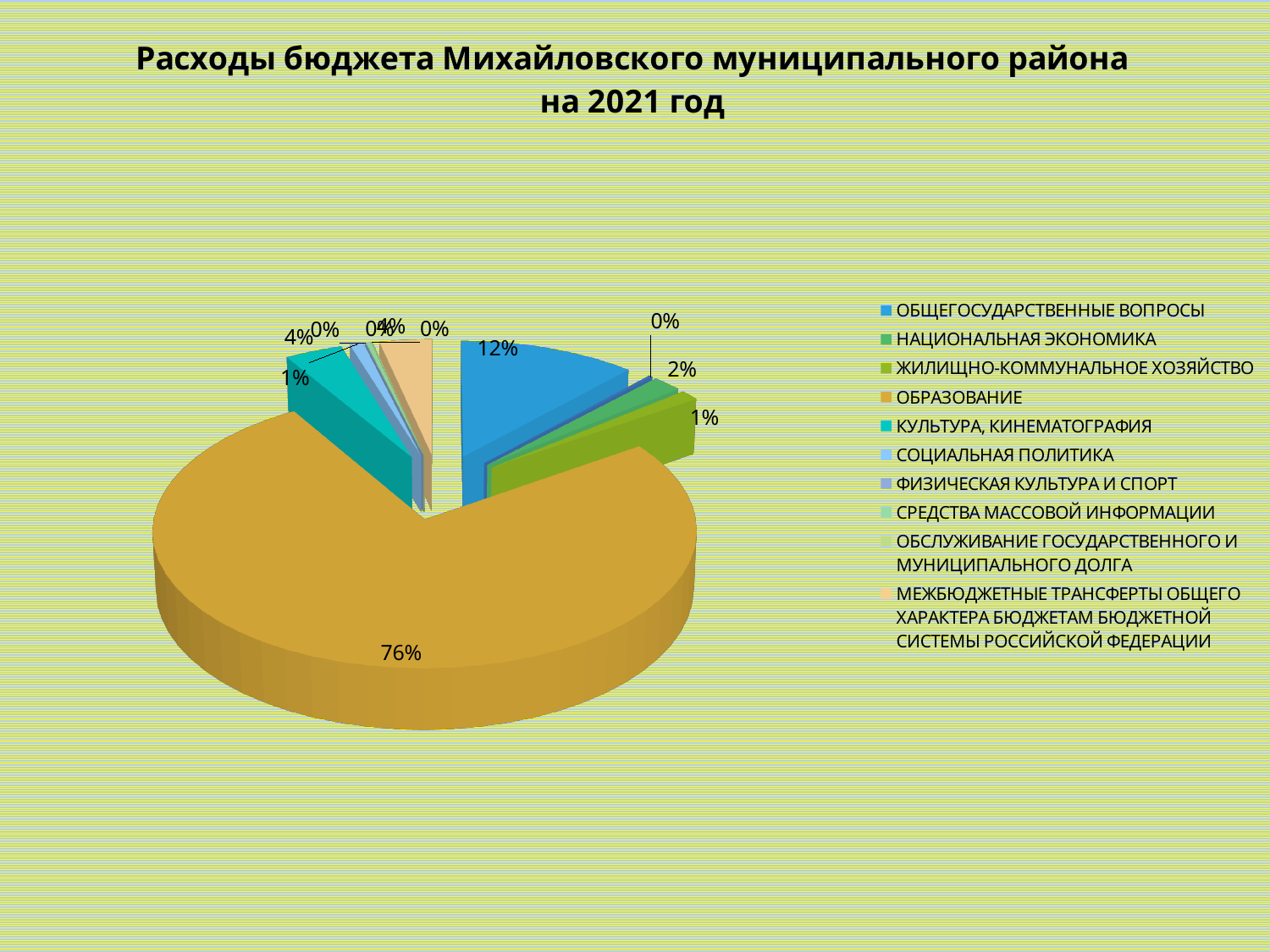
What share of the pie does ОБРАЗОВАНИЕ take? 76% By how many percentage points does ОБРАЗОВАНИЕ exceed ОБЩЕГОСУДАРСТВЕННЫЕ ВОПРОСЫ? 64 percentage points Which category has the largest slice of the pie? ОБРАЗОВАНИЕ Which is larger, the slice for НАЦИОНАЛЬНАЯ ЭКОНОМИКА or the slice for ЖИЛИЩНО-КОММУНАЛЬНОЕ ХОЗЯЙСТВО? НАЦИОНАЛЬНАЯ ЭКОНОМИКА What is the value shown for ОБЩЕГОСУДАРСТВЕННЫЕ ВОПРОСЫ? 12% What colour is the slice for ОБРАЗОВАНИЕ? orange What is the value shown for ЖИЛИЩНО-КОММУНАЛЬНОЕ ХОЗЯЙСТВО? 1% How many categories does the legend list? 10 What kind of chart is shown on the slide? pie chart What is the value shown for НАЦИОНАЛЬНАЯ ЭКОНОМИКА? 2% What is the title of the chart? Расходы бюджета Михайловского муниципального района на 2021 год Which is larger, the slice for ОБРАЗОВАНИЕ or the slice for ОБЩЕГОСУДАРСТВЕННЫЕ ВОПРОСЫ? ОБРАЗОВАНИЕ